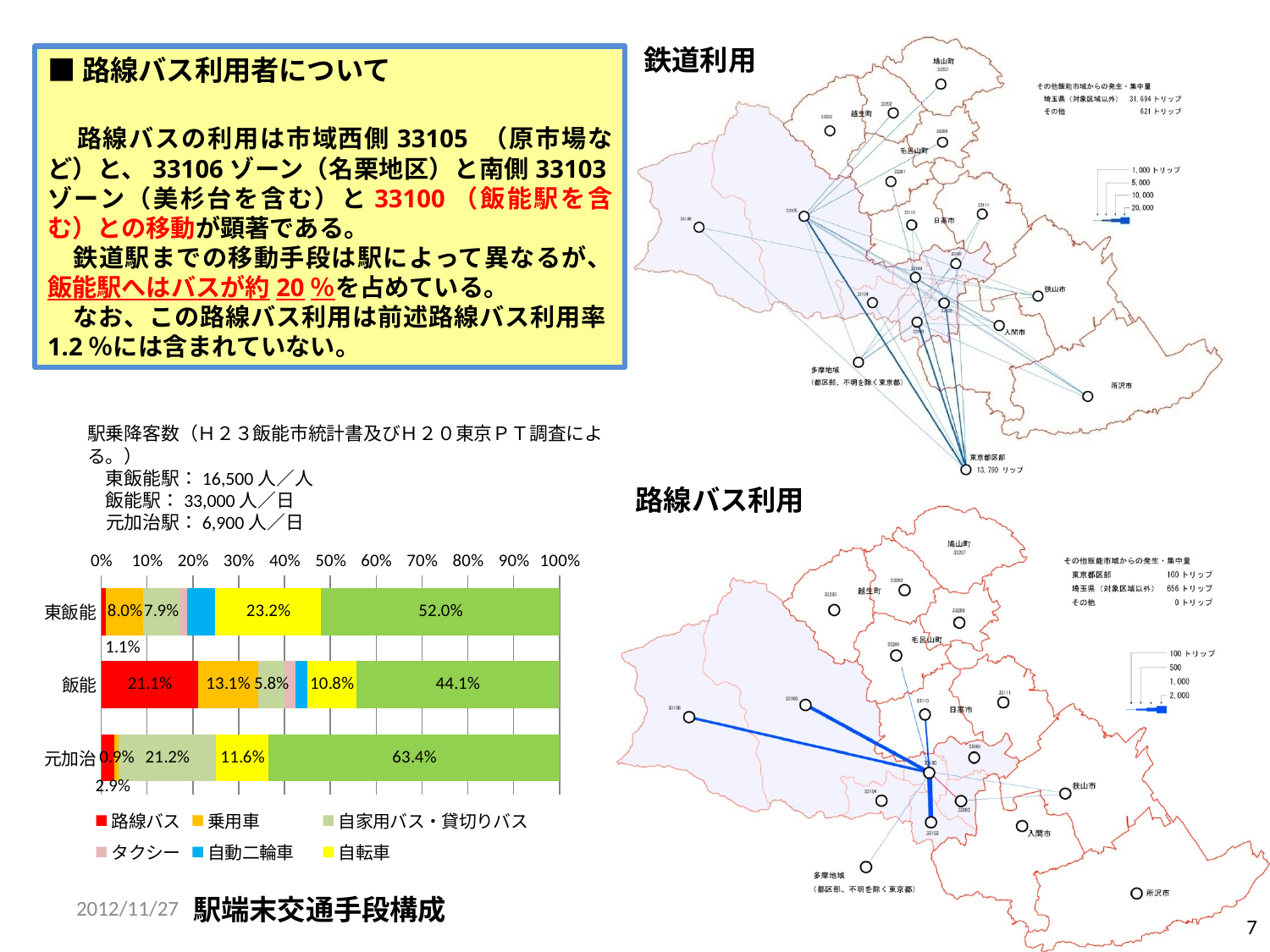
In the 駅端末交通手段構成 chart, which station has the highest 自転車 share? 東飯能 In the 駅端末交通手段構成 chart, what is the 路線バス share for 飯能? 21.1% In the 駅端末交通手段構成 chart, is the 路線バス share larger for 飯能 or for 元加治? 飯能 In the 駅端末交通手段構成 chart, what is the 路線バス share for 元加治? 2.9% In the 駅端末交通手段構成 chart, which station has the highest 路線バス share? 飯能 In the 駅端末交通手段構成 chart, what is the difference between the 自転車 share for 東飯能 and for 飯能? 12.4% In the 駅端末交通手段構成 chart, what is the 乗用車 share for 飯能? 13.1% In the 駅端末交通手段構成 chart, what is the 自転車 share for 飯能? 10.8% In the 駅端末交通手段構成 chart, what is the 自転車 share for 東飯能? 23.2% What kind of chart is the 駅端末交通手段構成 chart? Stacked bar chart How many stations are shown in the 駅端末交通手段構成 chart? 3 In the 駅端末交通手段構成 chart, what is the 自転車 share for 元加治? 11.6%